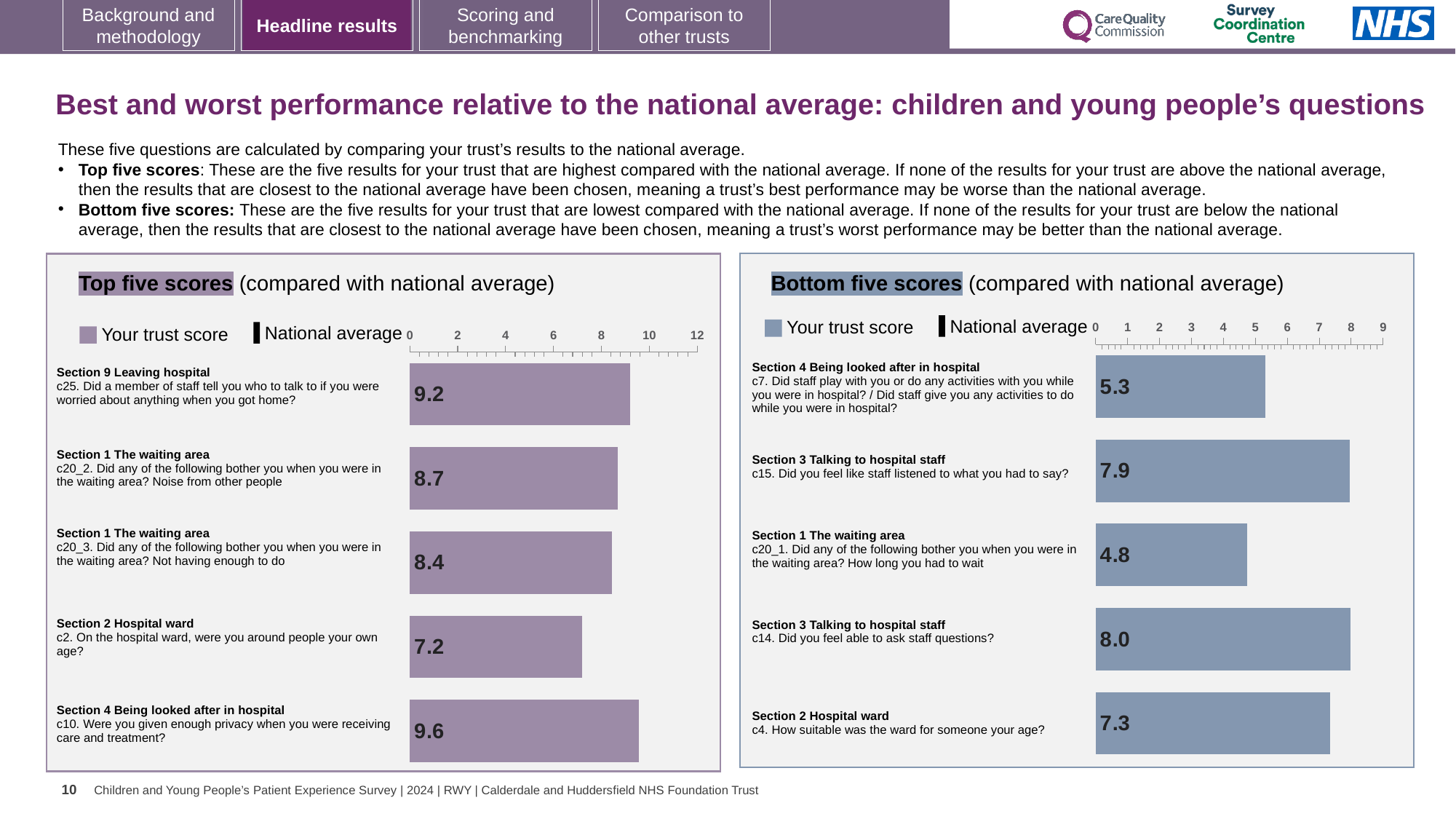
In the Bottom five scores chart, what is the trust score for c20_1 (How long you had to wait)? 4.8 In the Bottom five scores chart, which question has the lowest trust score? c20_1. How long you had to wait In the Bottom five scores chart, what is the difference between the trust scores for c14 and c20_1? 3.2 In the Top five scores chart, what is the difference between the trust scores for c10 and c2? 2.4 In the Bottom five scores chart, which question has the highest trust score? c14. Did you feel able to ask staff questions? In the Top five scores chart, what is the trust score for c25 (Did a member of staff tell you who to talk to if you were worried about anything when you got home?)? 9.2 How many series does the legend of the Bottom five scores chart list? 2 In the Top five scores chart, which question has the highest trust score? c10. Were you given enough privacy when you were receiving care and treatment? In the Top five scores chart, which question has the lowest trust score? c2. On the hospital ward, were you around people your own age? What type of chart is the Top five scores chart? Bar chart In the Bottom five scores chart, which has the larger trust score: c7 or c4? c4 How many questions are plotted in the Top five scores chart? 5